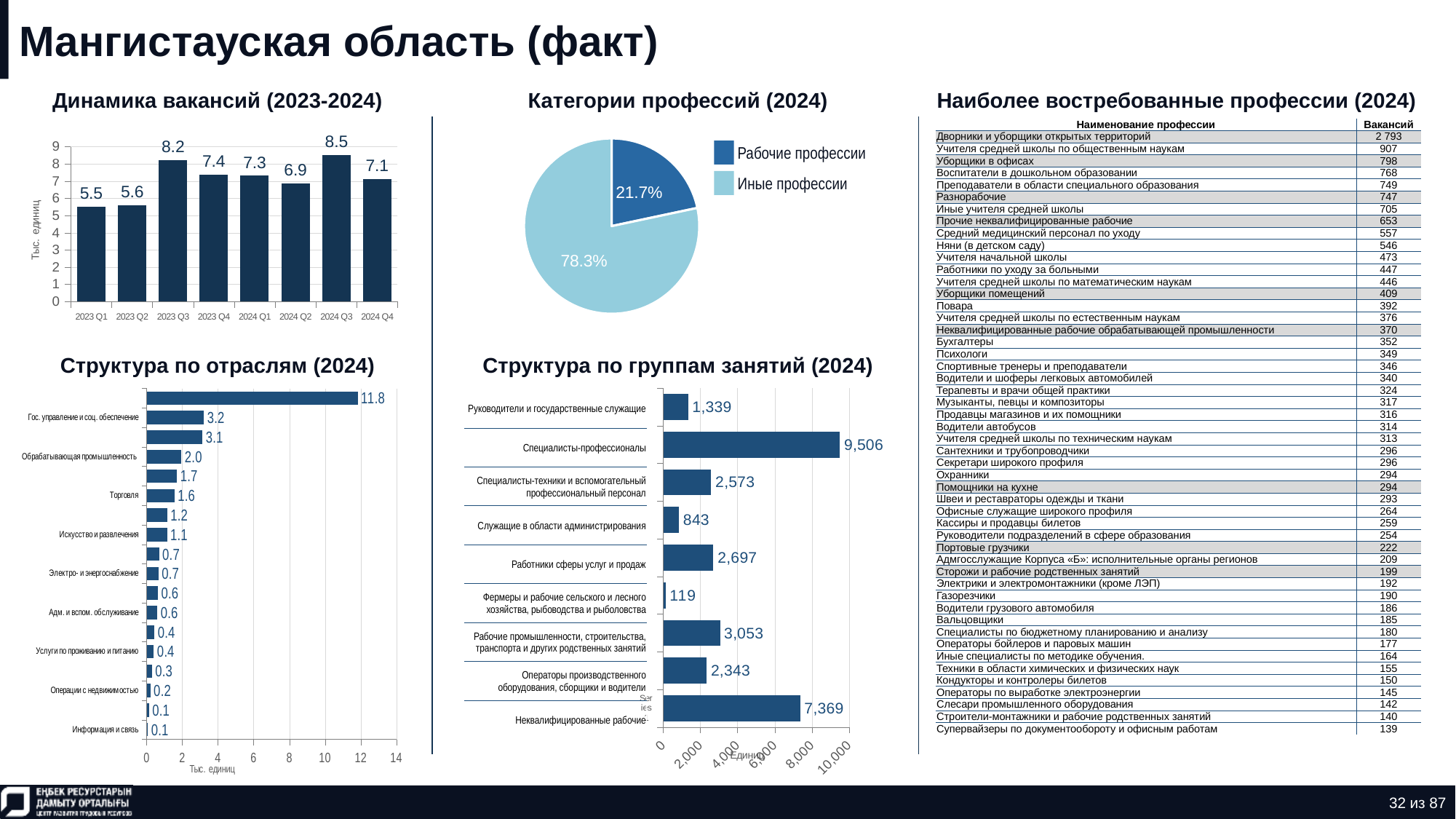
In the 'Динамика вакансий (2023-2024)' chart, which quarter has the highest value? 2024 Q3 In the 'Категории профессий (2024)' pie chart, what share is 'Рабочие профессии'? 21.7% In the 'Структура по отраслям (2024)' chart, what is the value for 'Торговля'? 1.6 How many occupation groups are shown in the 'Структура по группам занятий (2024)' chart? 9 In the 'Динамика вакансий (2023-2024)' chart, what is the difference between 2024 Q3 and 2024 Q4? 1.4 In the 'Динамика вакансий (2023-2024)' chart, which quarter has the lowest value? 2023 Q1 How many quarters are shown in the 'Динамика вакансий (2023-2024)' chart? 8 In the 'Динамика вакансий (2023-2024)' chart, what is the value for 2023 Q3? 8.2 In the 'Структура по группам занятий (2024)' chart, which group has the lowest value? Фермеры и рабочие сельского и лесного хозяйства, рыбоводства и рыболовства What type of chart is 'Категории профессий (2024)'? Pie chart In the 'Структура по группам занятий (2024)' chart, which is larger: 'Работники сферы услуг и продаж' or 'Операторы производственного оборудования, сборщики и водители'? Работники сферы услуг и продаж In the 'Структура по группам занятий (2024)' chart, what is the value for 'Специалисты-профессионалы'? 9,506